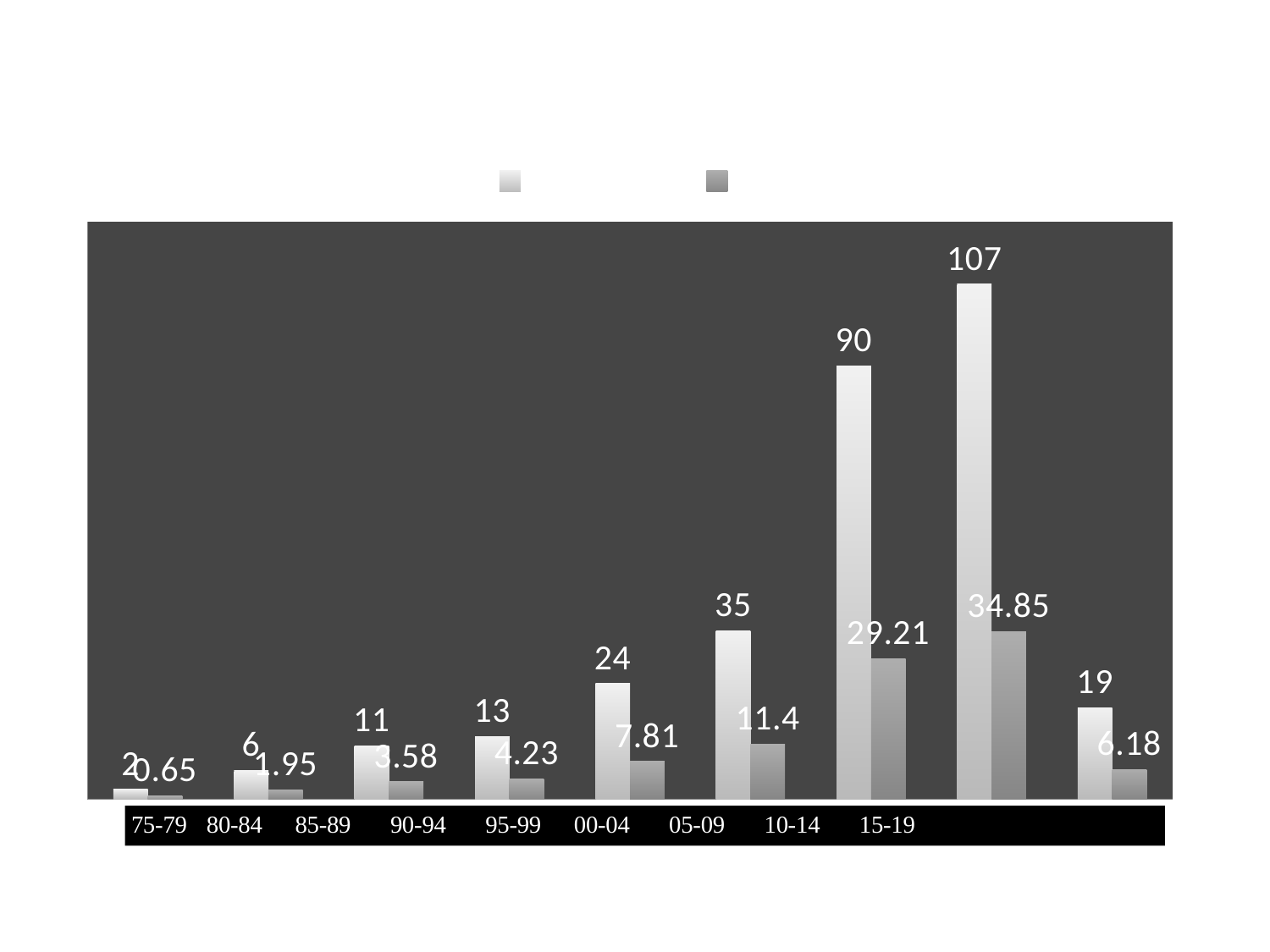
What is the highest value among the light-coloured bars? 107 What is the highest value among the dark-coloured bars? 34.85 What is the lowest value among the light-coloured bars? 2 How many series does the legend list? 2 Which series has the larger values in every group, the light-coloured or the dark-coloured one? the light-coloured series What is the difference between the two largest dark-coloured bar values (34.85 and 29.21)? 5.64 What is the difference between the two tallest light-coloured bars (107 and 90)? 17 In the group where the light bar is 35, what is the value of the dark bar? 11.4 What is the lowest value among the dark-coloured bars? 0.65 In the last group of bars on the right, what is the value of the light-coloured bar? 19 What kind of chart is shown on the slide? bar chart How many groups of bars are plotted in the chart? 9